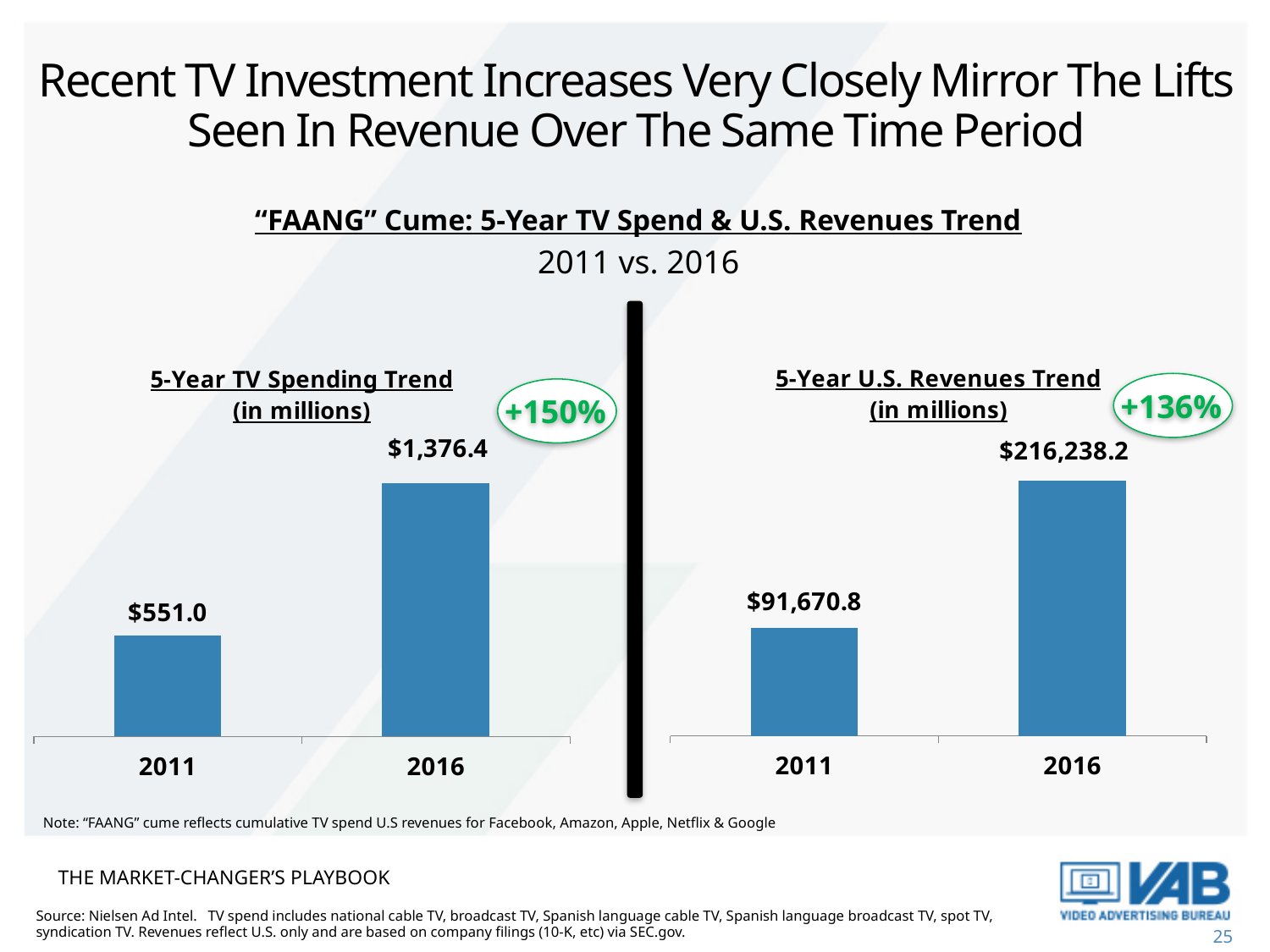
In the 5-Year TV Spending Trend chart, what is the difference between the 2016 and 2011 values? $825.4 How many bars are shown in the 5-Year TV Spending Trend chart? 2 What kind of chart is the 5-Year U.S. Revenues Trend chart? bar chart In the 5-Year U.S. Revenues Trend chart, what is the difference between the 2016 and 2011 values? $124,567.4 In the 5-Year U.S. Revenues Trend chart, what is the value for 2011? $91,670.8 In the 5-Year TV Spending Trend chart, what is the value for 2011? $551.0 In the 5-Year U.S. Revenues Trend chart, which year has the lower value? 2011 What percentage increase is shown in the green circle next to the 5-Year TV Spending Trend chart? +150% In the 5-Year U.S. Revenues Trend chart, is the value for 2016 larger or smaller than the value for 2011? larger In the 5-Year U.S. Revenues Trend chart, what is the value for 2016? $216,238.2 In the 5-Year TV Spending Trend chart, which year has the higher value? 2016 In the 5-Year TV Spending Trend chart, what is the value for 2016? $1,376.4